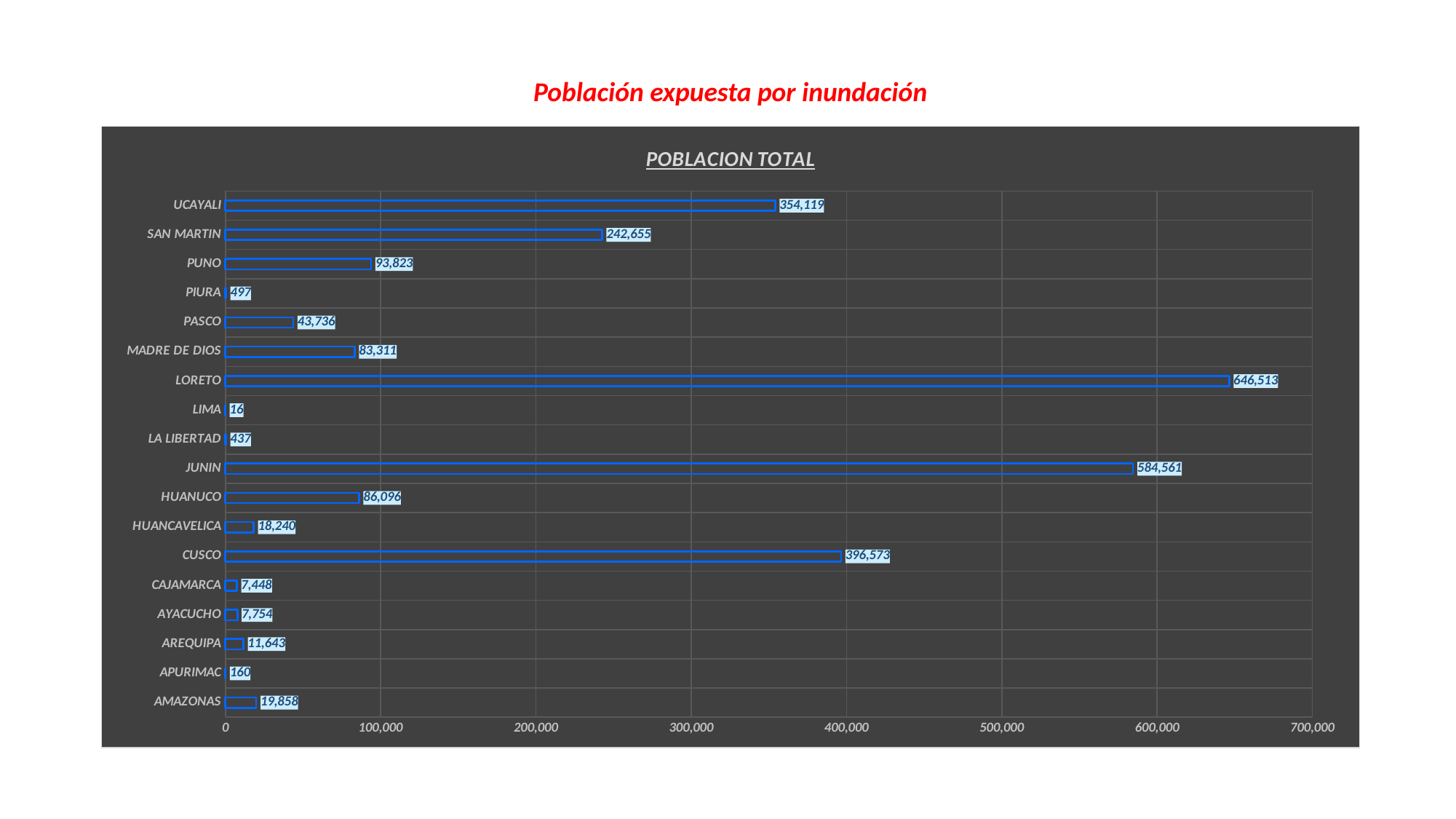
Is the value for SAN MARTIN greater or less than 200,000? greater Which is larger, the value for AYACUCHO or the value for CAJAMARCA? AYACUCHO What is the title of the chart? POBLACION TOTAL What is the difference between the values for LORETO and JUNIN? 61,952 What is the value for CUSCO? 396,573 What is the difference between the values for CUSCO and UCAYALI? 42,454 What is the value for HUANCAVELICA? 18,240 How many categories are shown in the chart? 18 Which category has the highest value? LORETO Which category has the lowest value? LIMA What kind of chart is shown on the slide? bar chart What is the value for LORETO? 646,513